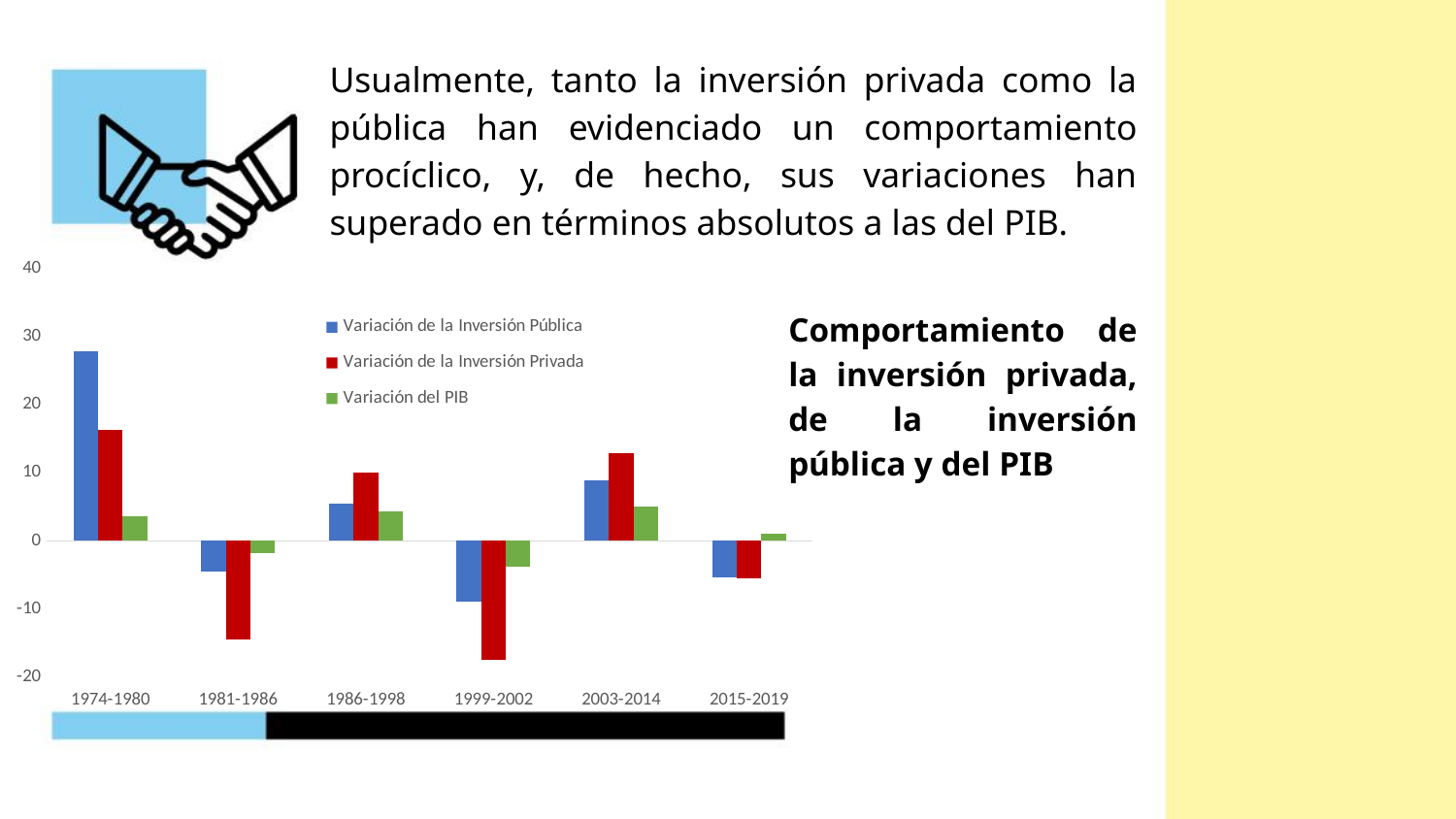
In which period is the Variación de la Inversión Privada lowest? 1999-2002 How many periods are shown on the x axis of the chart? 6 Which series in the chart is shown in red? Variación de la Inversión Privada For 2003-2014, which is larger: Variación de la Inversión Privada or Variación del PIB? Variación de la Inversión Privada For 1974-1980, which is larger: Variación de la Inversión Pública or Variación de la Inversión Privada? Variación de la Inversión Pública Is the value of Variación de la Inversión Pública for 1974-1980 greater or less than 20? greater Is the value of Variación de la Inversión Privada for 1999-2002 greater or less than -10? less Is the value of Variación de la Inversión Privada for 1981-1986 greater or less than -10? less Which series in the chart is shown in green? Variación del PIB In which period is the Variación de la Inversión Pública highest? 1974-1980 What kind of chart is shown on the slide? bar chart How many series does the chart's legend list? 3